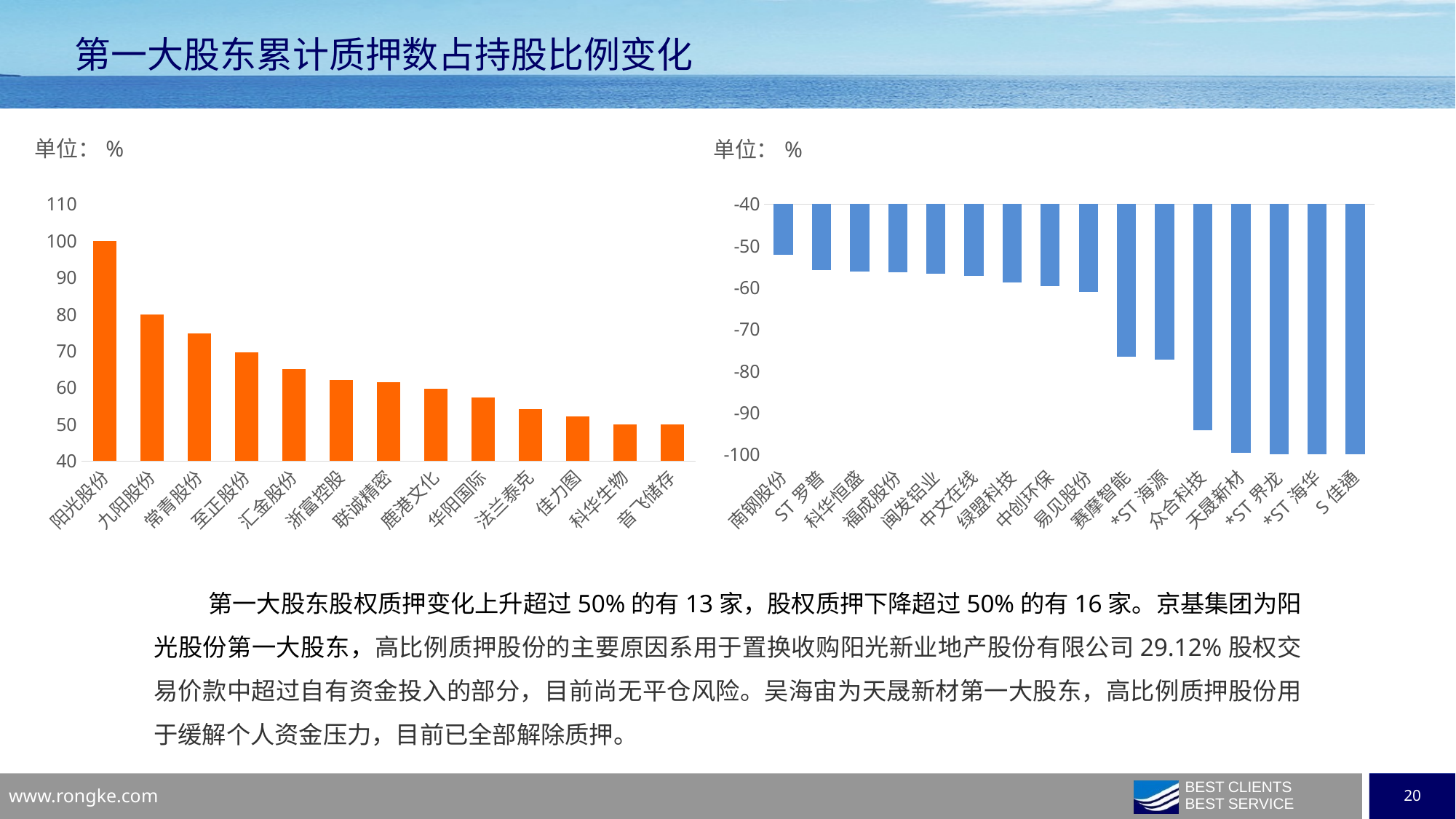
In the left chart, which category has the highest value? 阳光股份 In the right chart, is the value for 赛摩智能 greater or less than -70? less In the right chart, is the value for 南钢股份 greater or less than -60? greater In the left chart, is the value for 常青股份 greater or less than 70? greater In the left chart, what is the value for 阳光股份? 100 In the left chart, which is larger, the value for 九阳股份 or the value for 汇金股份? 九阳股份 In the left chart, do the values rise or fall from left to right along the x axis? fall How many categories are shown in the left chart? 13 What kind of chart is the left chart on the slide? bar chart What unit is stated above each chart? % How many categories are shown in the right chart? 16